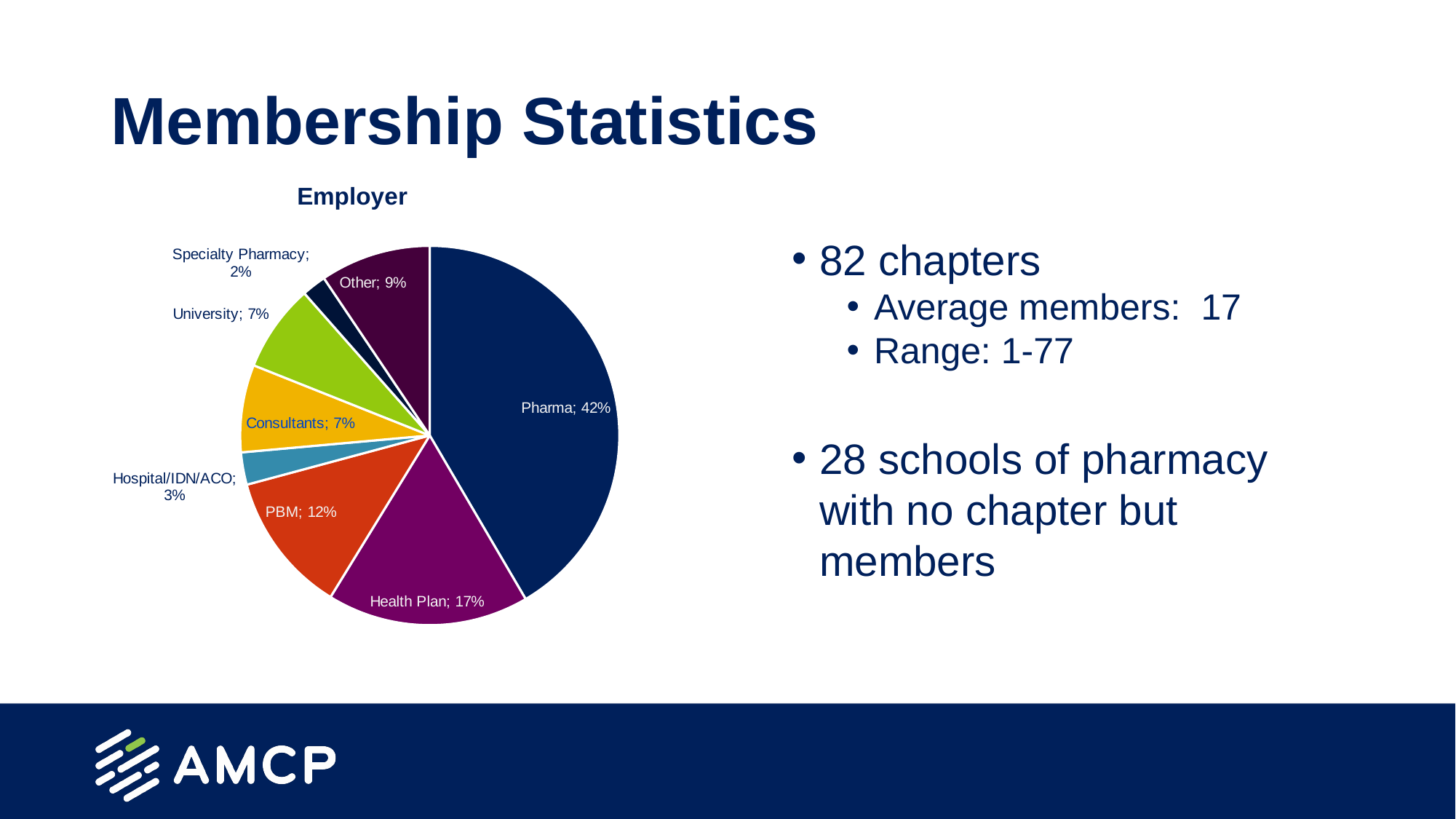
What share of the pie does Pharma account for? 42% What percentage is shown for Hospital/IDN/ACO? 3% What percentage is shown for Health Plan? 17% How many categories are shown in the pie chart? 8 What type of chart is shown on the slide? Pie chart What is the combined share of University and Consultants? 14% Which category has the smallest slice of the pie? Specialty Pharmacy What is the difference in percentage points between Pharma and Health Plan? 25 What percentage is shown for PBM? 12% Which category has the largest slice of the pie? Pharma What is the title of the chart? Employer Which is larger, the share for PBM or the share for Other? PBM